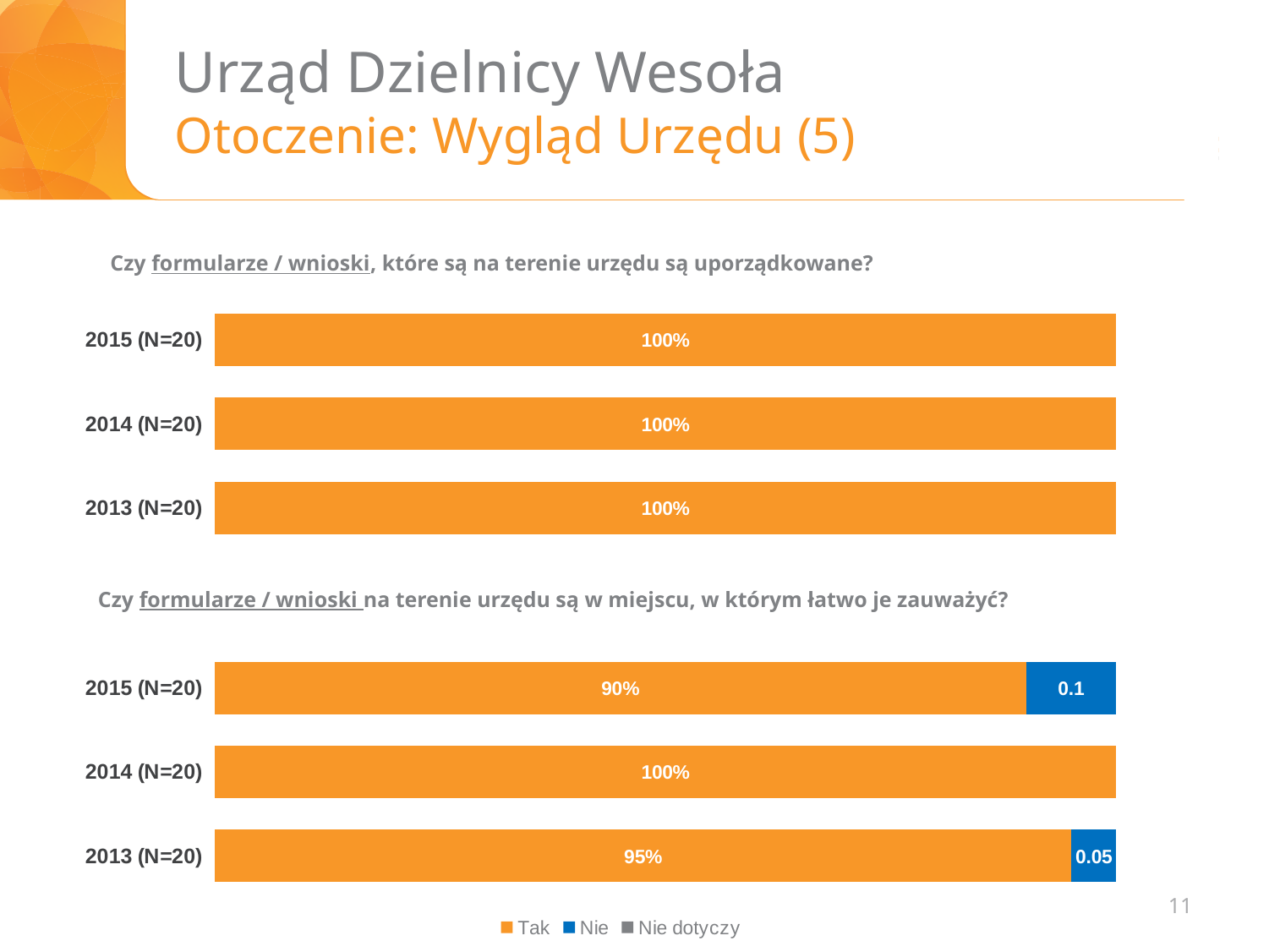
In the bottom chart, what is the difference between the 'Tak' values for 2013 (N=20) and 2015 (N=20)? 5% How many series does the legend at the bottom of the slide list? 3 In the bottom chart, what is the 'Tak' value for 2013 (N=20)? 95% In the bottom chart, what is the 'Nie' value shown for 2015 (N=20)? 0.1 In the bottom chart, what is the 'Nie' value shown for 2013 (N=20)? 0.05 In the bottom chart, is the 'Tak' value larger for 2013 (N=20) or 2015 (N=20)? 2013 (N=20) What type of chart is the bottom chart? Bar chart In the bottom chart, which year has the highest 'Tak' value? 2014 (N=20) In the bottom chart, which year has the lowest 'Tak' value? 2015 (N=20) In the top chart, what is the 'Tak' value for 2014 (N=20)? 100% In the bottom chart, what is the 'Tak' value for 2015 (N=20)? 90% How many year categories does the top chart show? 3